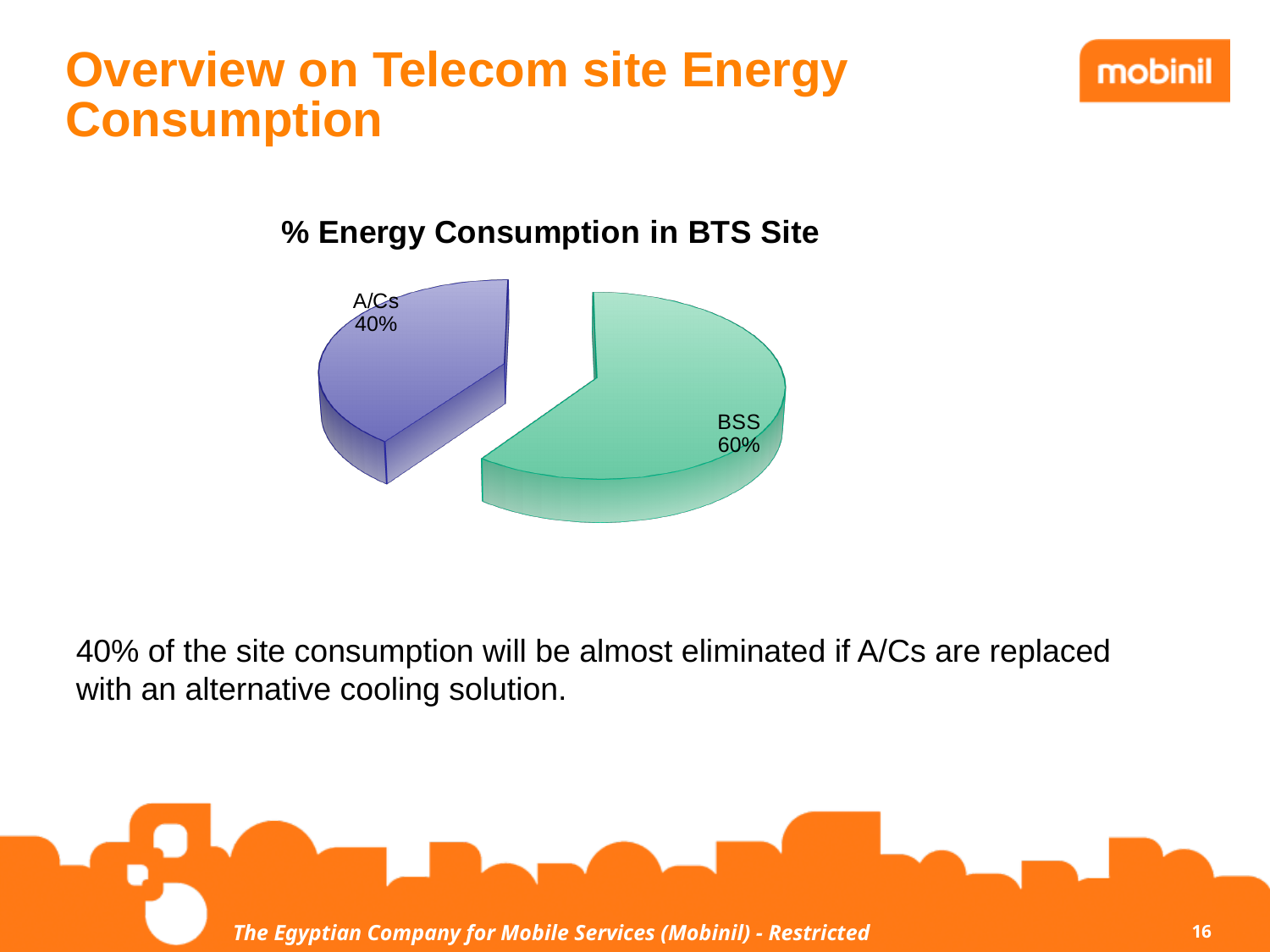
What kind of chart is shown on the slide? pie chart Which category has the smallest share of energy consumption? A/Cs How many slices does the pie chart have? 2 What share of energy consumption is attributed to A/Cs? 40% What colour is the BSS slice? green Which is larger, the share for A/Cs or the share for BSS? BSS What share of energy consumption is attributed to BSS? 60% What is the difference in percentage points between the BSS and A/Cs shares? 20% What is the combined share of the A/Cs and BSS slices? 100% What is the title of the chart? % Energy Consumption in BTS Site Which category has the largest share of energy consumption? BSS